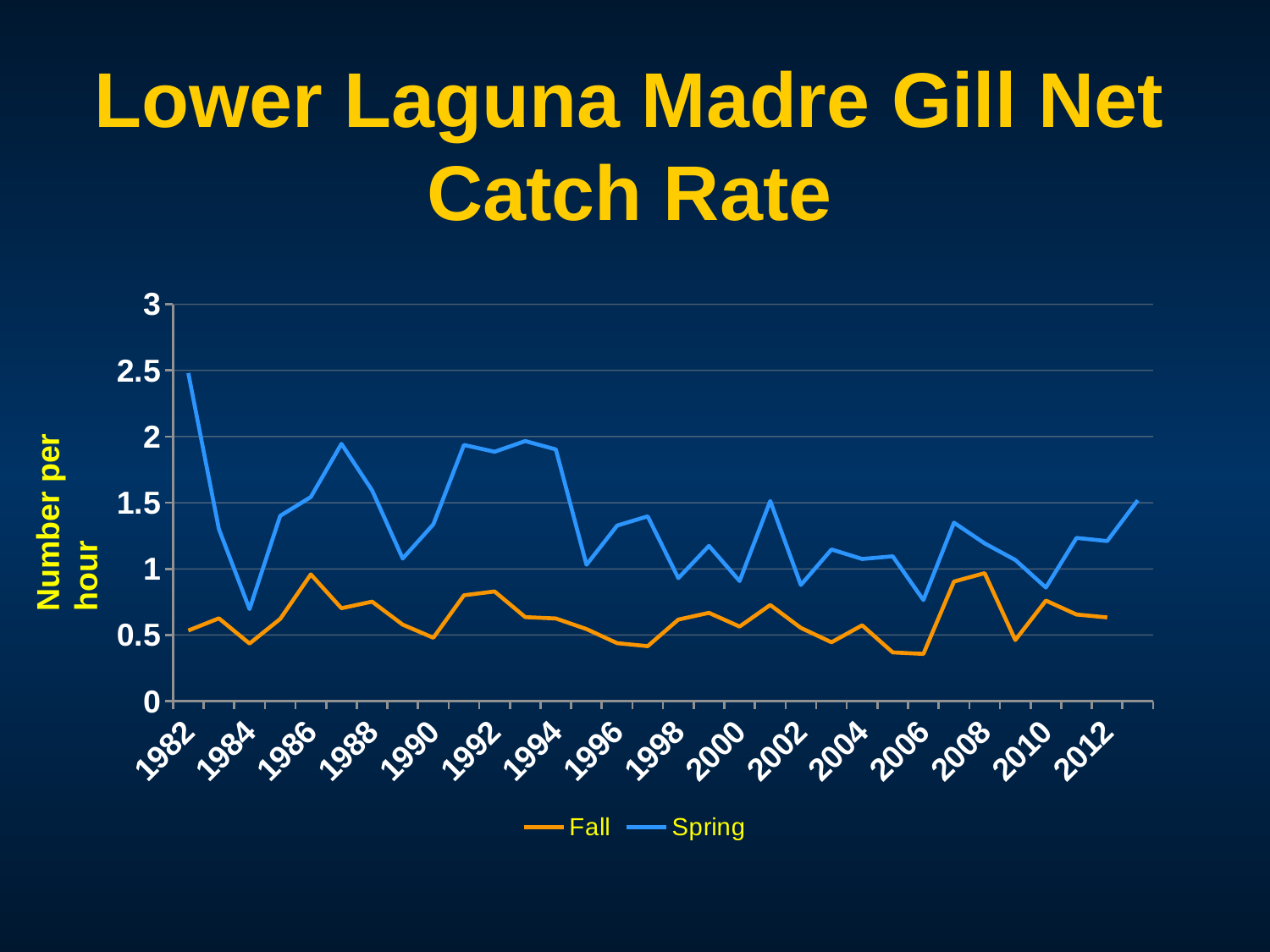
What are the two series named in the legend? Fall and Spring Does the Spring series rise or fall between 1982 and 1984? fall Is the Spring value for 1982 greater or less than 2? greater In which year does the Spring series reach its highest value? 1982 Is the Spring value for 1984 greater or less than 1? less Is the Fall value for 2006 greater or less than 0.5? less How many series does the legend list? 2 What kind of chart is shown on the slide? line chart In 1992, which series has the larger value, Fall or Spring? Spring What is the label on the vertical axis? Number per hour